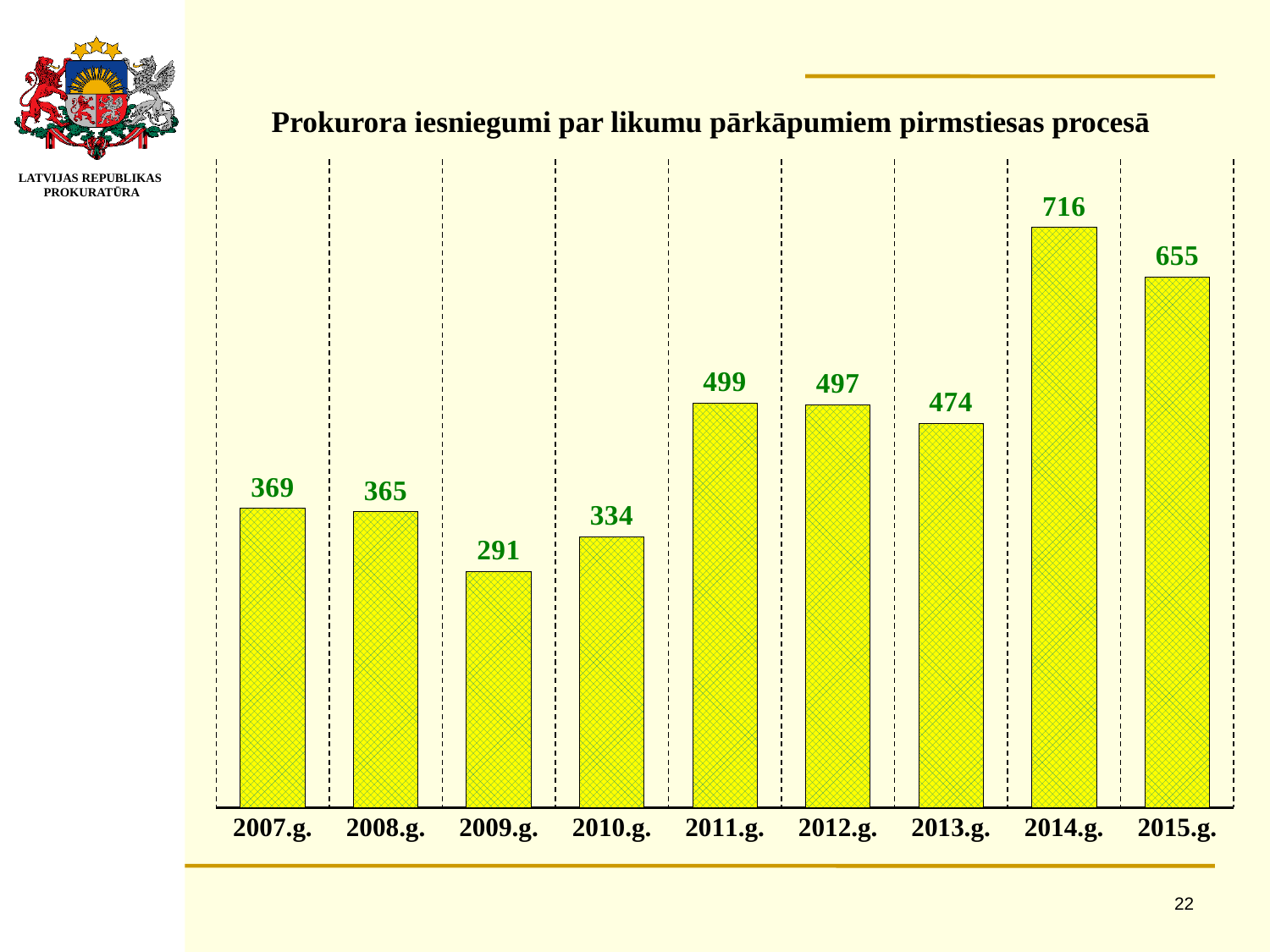
Which year has the highest value? 2014.g. What is the value for 2009.g.? 291 Do the values rise or fall from 2009.g. to 2011.g.? rise How many years are shown on the x axis? 9 What is the difference between the values for 2007.g. and 2009.g.? 78 What is the title of the chart? Prokurora iesniegumi par likumu pārkāpumiem pirmstiesas procesā Which year has the lowest value? 2009.g. What is the difference between the values for 2014.g. and 2015.g.? 61 What is the value for 2011.g.? 499 What kind of chart is shown on the slide? bar chart What is the value for 2014.g.? 716 Which is larger, the value for 2013.g. or the value for 2015.g.? 2015.g.